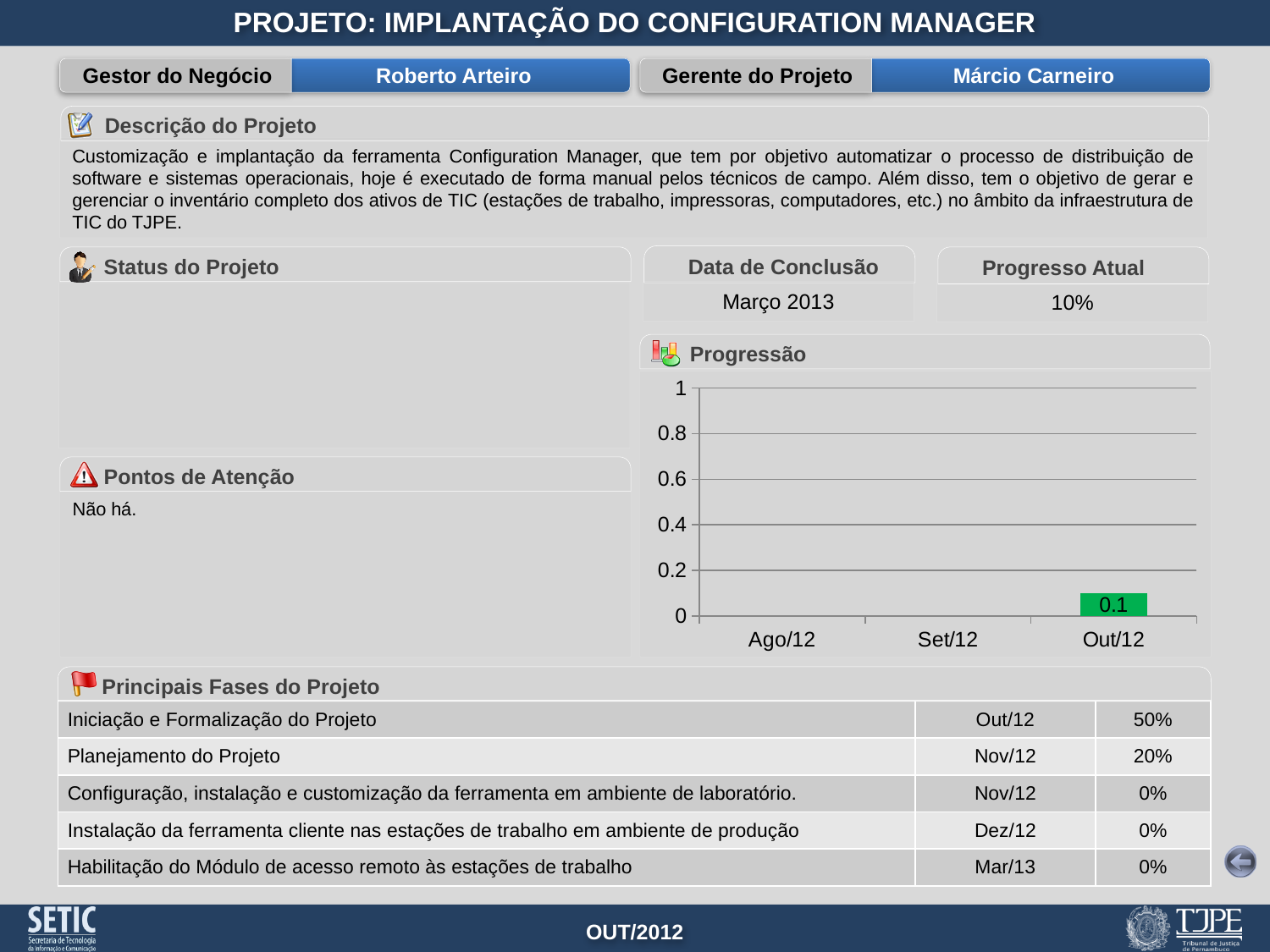
What kind of chart is the Progressão chart? bar chart What colour is the bar for Out/12 in the Progressão chart? green Which is the first month on the x axis of the Progressão chart? Ago/12 Is the value for Out/12 in the Progressão chart greater or less than 0.2? less How many bars are visible in the Progressão chart? 1 How many months are listed on the x axis of the Progressão chart? 3 What is the value shown for Out/12 in the Progressão chart? 0.1 Is the value for Out/12 in the Progressão chart greater or less than 0.6? less What is the title of the chart on the slide? Progressão Which month has the highest value in the Progressão chart? Out/12